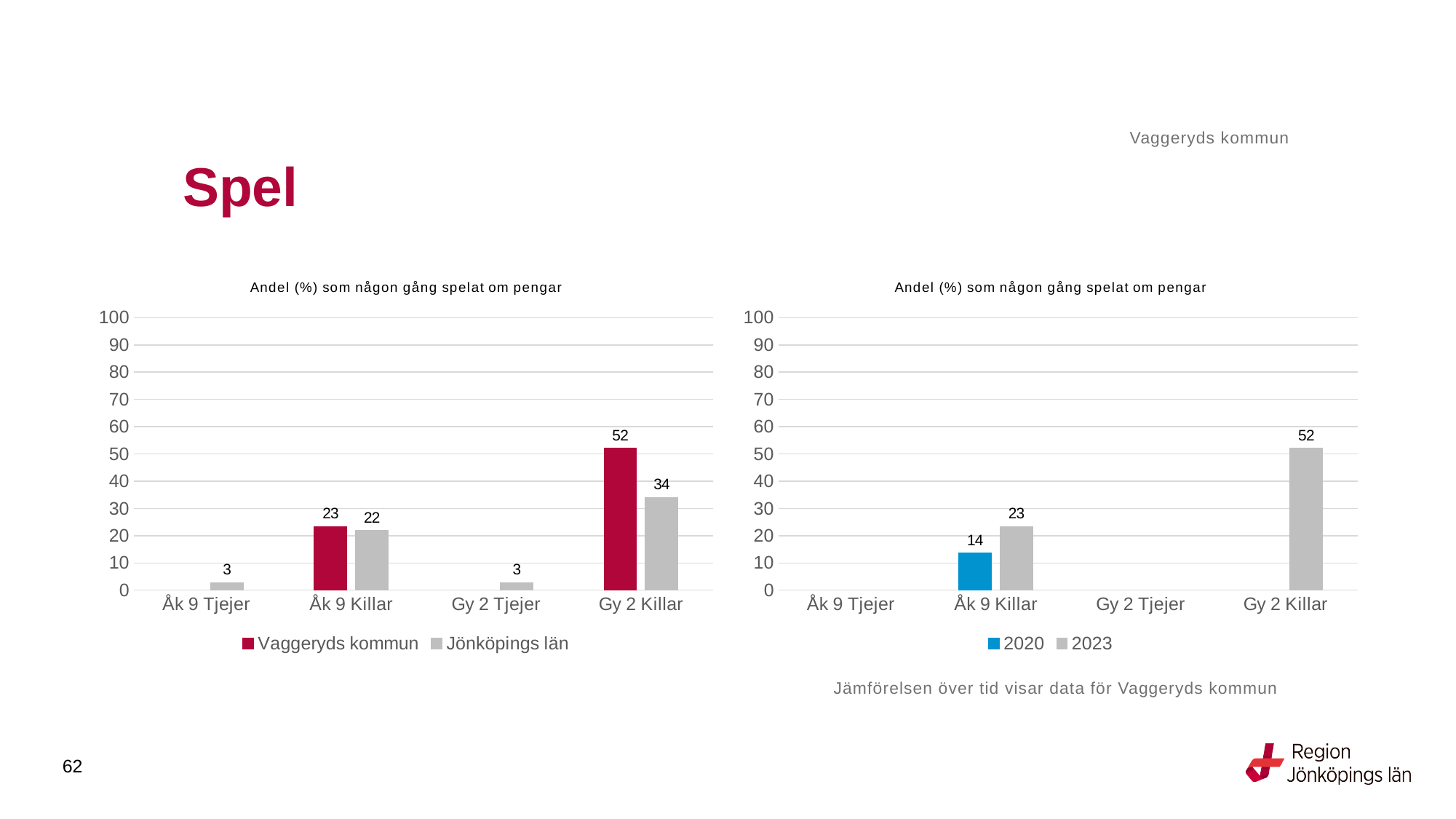
How many categories are shown on the x axis of the right chart? 4 In the left chart, which is larger for Åk 9 Killar: Vaggeryds kommun or Jönköpings län? Vaggeryds kommun In the right chart, what is the 2023 value for Gy 2 Killar? 52 What kind of chart is the right chart? Bar chart In the left chart, what is the value for Gy 2 Killar in the Vaggeryds kommun series? 52 In the left chart, what is the difference between the Vaggeryds kommun and Jönköpings län values for Gy 2 Killar? 18 How many series does the legend of the left chart list? 2 In the right chart, what is the difference between the 2023 and 2020 values for Åk 9 Killar? 9 In the left chart, what is the value for Åk 9 Tjejer in the Jönköpings län series? 3 In the left chart, which category has the highest Jönköpings län value? Gy 2 Killar In the left chart, what is the value for Åk 9 Killar in the Jönköpings län series? 22 In the right chart, what is the 2020 value for Åk 9 Killar? 14